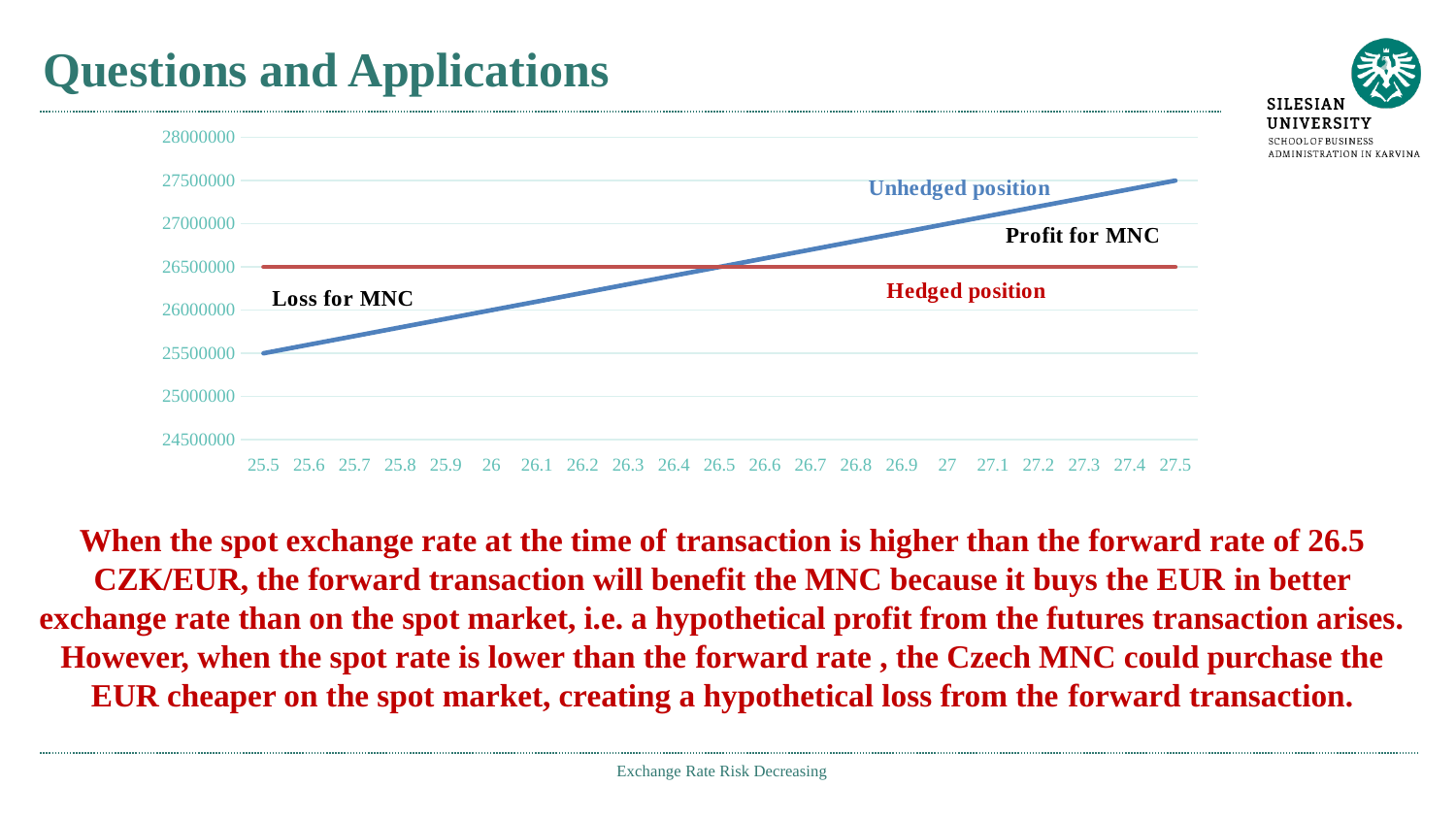
What is the difference between the Unhedged position at 27.5 and at 25.5? 2000000 How many exchange rate values are shown on the x axis? 21 At an exchange rate of 27, which line is higher: Unhedged position or Hedged position? Unhedged position What type of chart is shown on the slide? Line chart What is the value of the Unhedged position at an exchange rate of 25.5? 25500000 Does the Hedged position line rise, fall or stay flat along the x axis? Stays flat At an exchange rate of 26, which line is higher: Unhedged position or Hedged position? Hedged position Is the value of the Unhedged position at an exchange rate of 26 greater or less than 26500000? less What is the value of the Unhedged position at an exchange rate of 27.5? 27500000 Does the Unhedged position line rise or fall as the exchange rate increases along the x axis? Rises At which exchange rate do the Unhedged position and Hedged position lines cross? 26.5 What is the value of the Hedged position line? 26500000